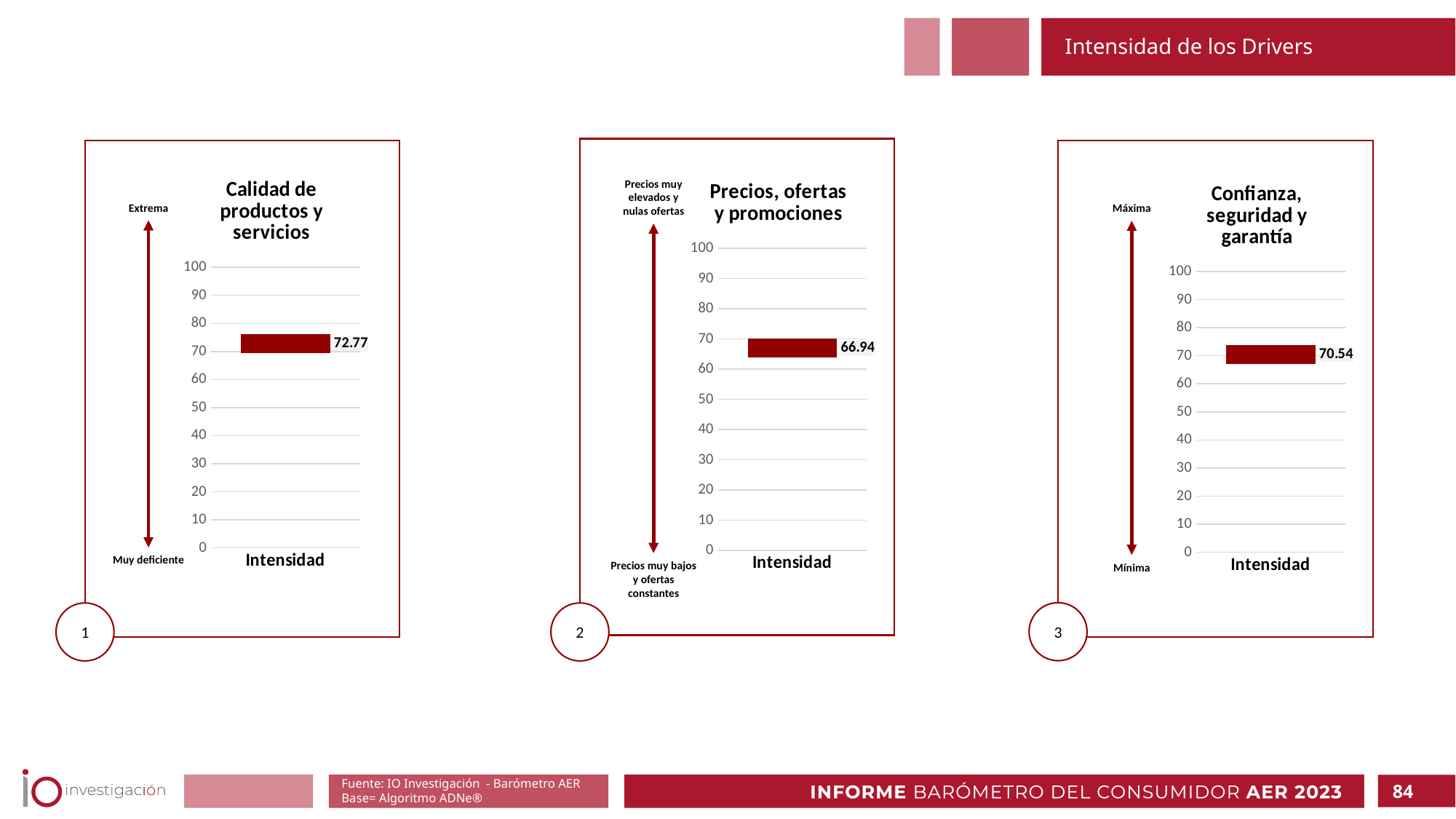
What is the difference between the Intensidad value in the 'Calidad de productos y servicios' chart and the one in the 'Precios, ofertas y promociones' chart? 5.83 Across the three charts on the slide, which driver has the highest Intensidad value? Calidad de productos y servicios How many bars are plotted in the chart titled 'Confianza, seguridad y garantía'? 1 In the chart titled 'Confianza, seguridad y garantía', what is the value of the Intensidad bar? 70.54 In the chart titled 'Precios, ofertas y promociones', is the Intensidad value greater or less than 70? less What is the maximum value shown on the vertical axis of the 'Precios, ofertas y promociones' chart? 100 In the chart titled 'Precios, ofertas y promociones', what is the value of the Intensidad bar? 66.94 What type of chart is the 'Calidad de productos y servicios' chart? bar chart Across the three charts on the slide, which driver has the lowest Intensidad value? Precios, ofertas y promociones Which is larger: the Intensidad value in the 'Confianza, seguridad y garantía' chart or in the 'Calidad de productos y servicios' chart? Calidad de productos y servicios In the chart titled 'Calidad de productos y servicios', what is the value of the Intensidad bar? 72.77 What is the difference between the Intensidad value in the 'Confianza, seguridad y garantía' chart and the one in the 'Precios, ofertas y promociones' chart? 3.60